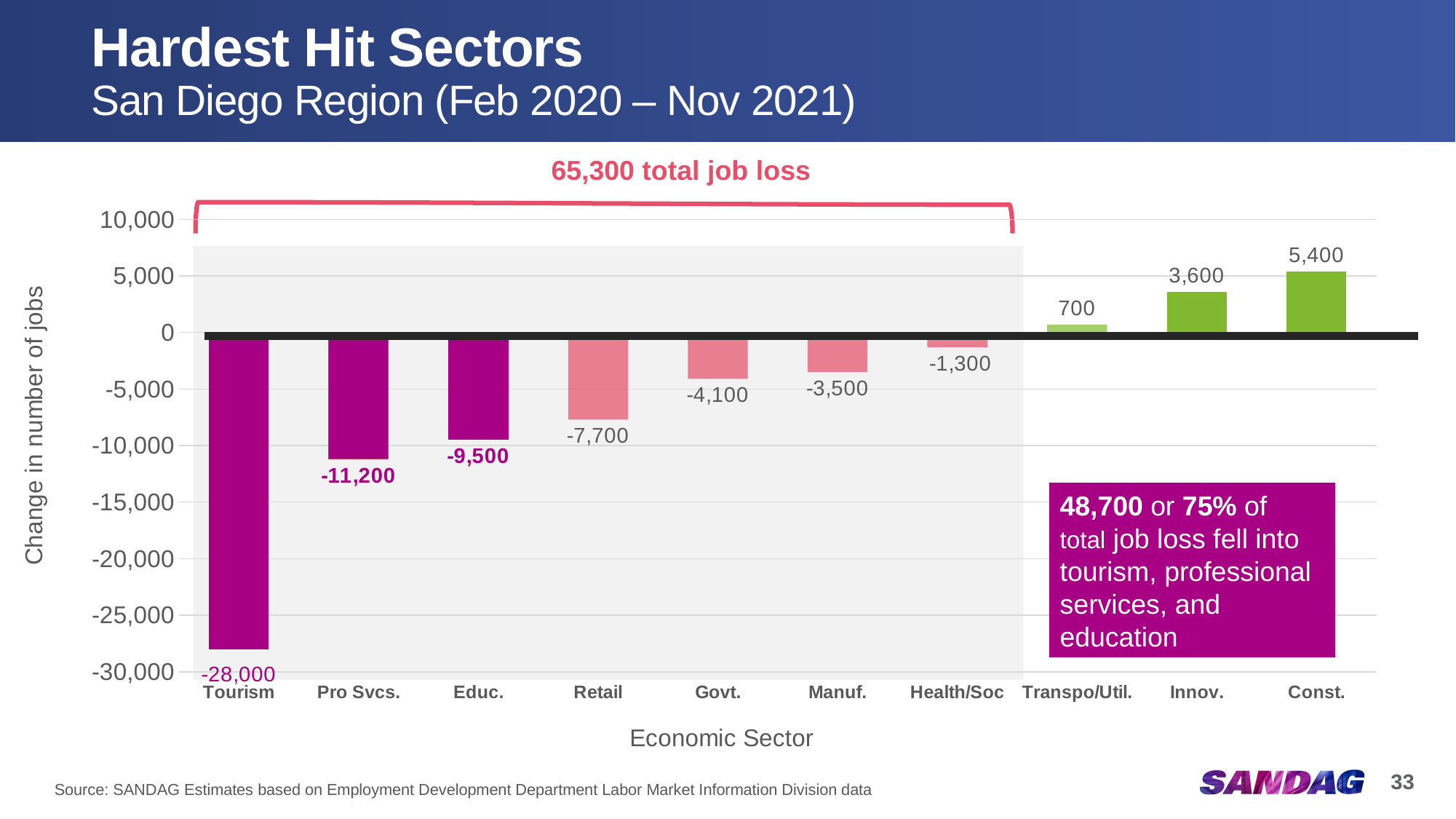
Which economic sector has the largest job gain? Const. What is the change in number of jobs for Const.? 5,400 What is the label of the y axis? Change in number of jobs What is the change in number of jobs for Tourism? -28,000 Which sector lost more jobs, Govt. or Manuf.? Govt. What is the change in number of jobs for Pro Svcs.? -11,200 What total job loss is labelled above the bracket on the chart? 65,300 What is the change in number of jobs for Health/Soc? -1,300 How many economic sectors are shown on the x axis? 10 What is the difference between the job change for Educ. and Retail? 1,800 What kind of chart is shown on the slide? bar chart Which economic sector has the largest job loss? Tourism